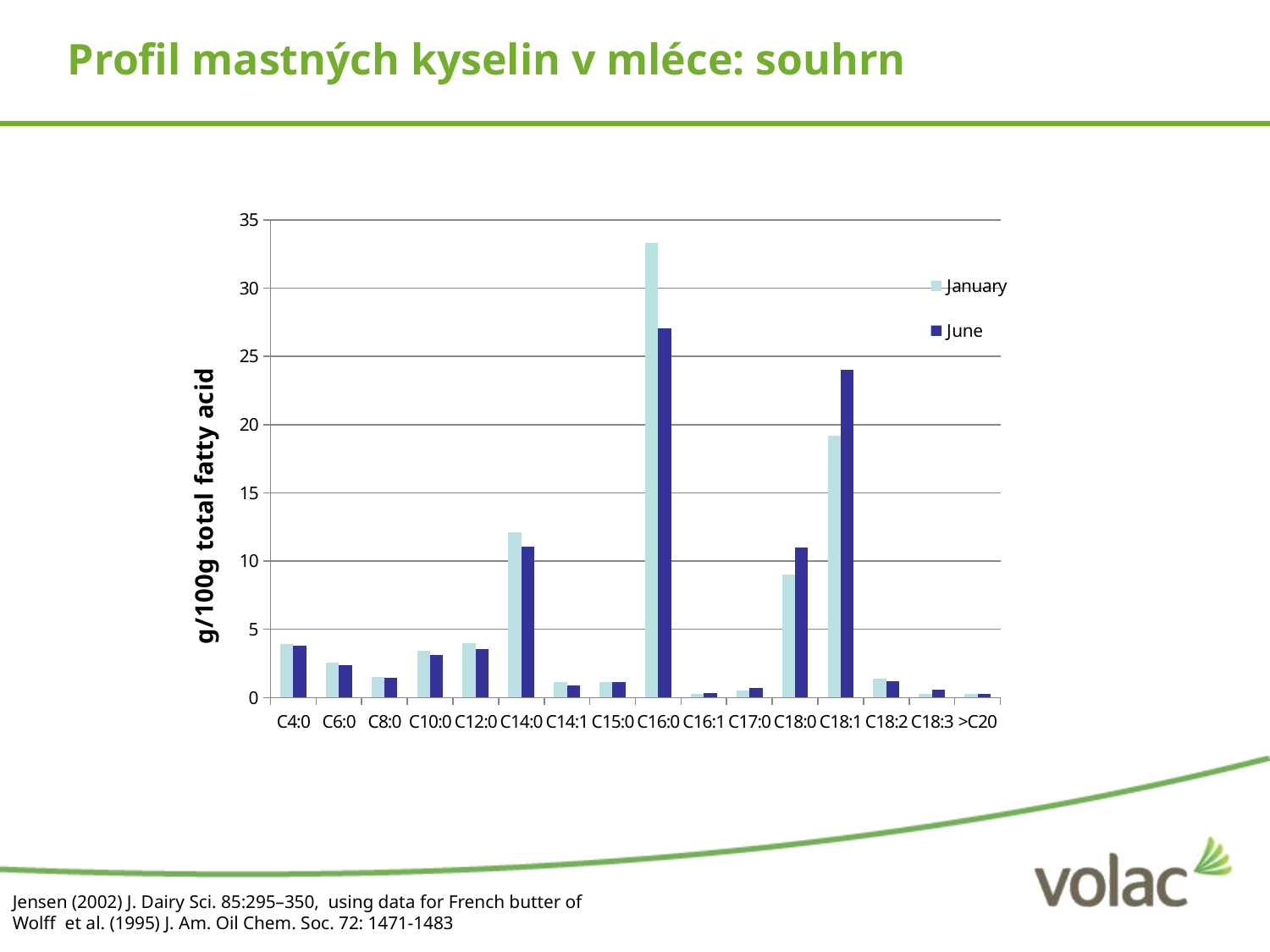
Which fatty acid has the highest January value? C16:0 What is the label of the y axis? g/100g total fatty acid Is the January value for C16:0 greater or less than 30? greater What kind of chart is shown on the slide? bar chart How many series does the legend list? 2 Is the June value for C18:1 greater or less than 20? greater For C16:0, which is larger, the January value or the June value? January Which fatty acid has the highest June value? C16:0 Is the January value for C14:0 greater or less than 10? greater How many fatty acid categories are shown on the x axis? 16 For C18:1, which is larger, the January value or the June value? June